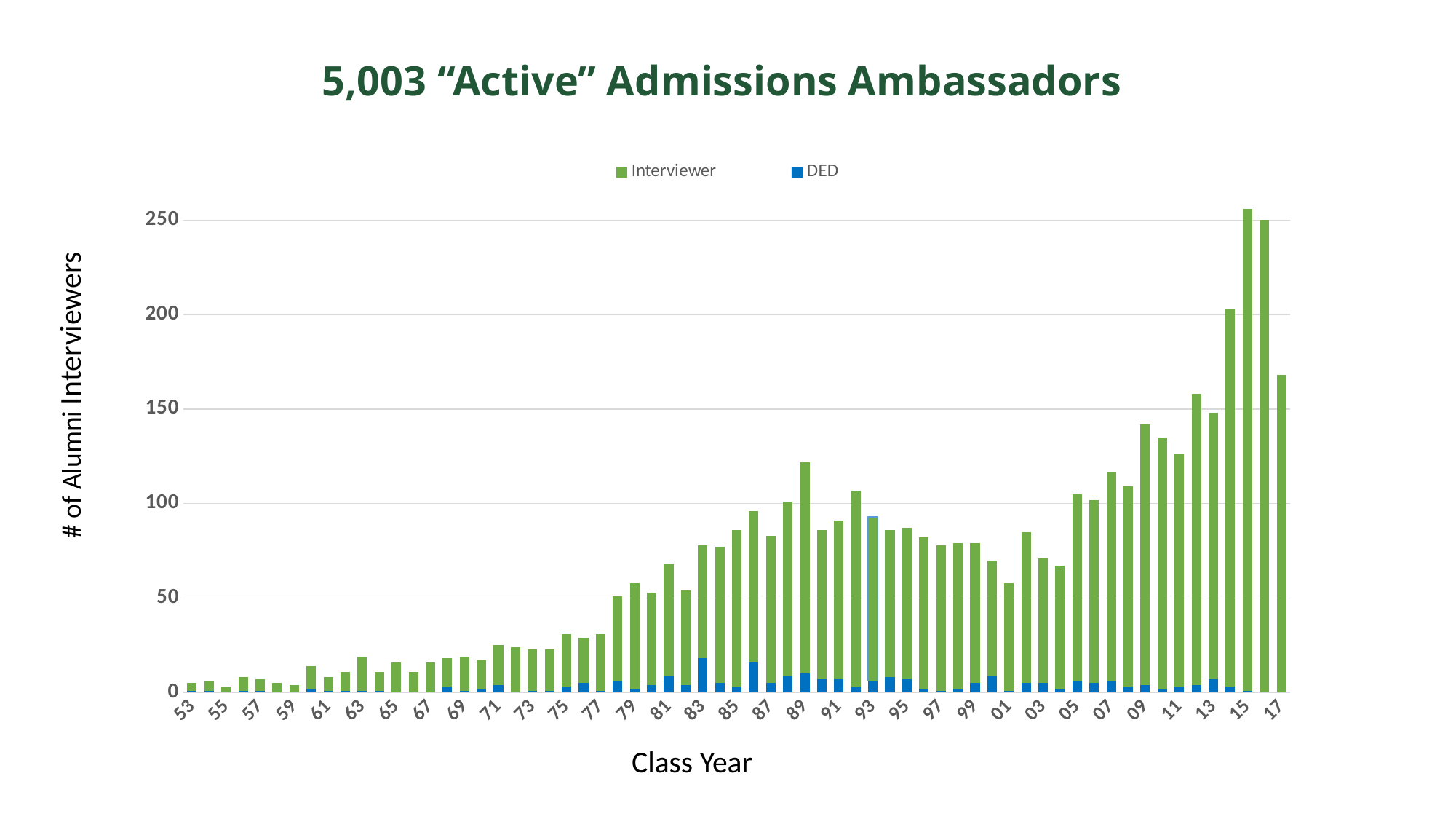
Which class year has the taller bar, 15 or 17? 15 What is the title of the chart? 5,003 "Active" Admissions Ambassadors Is the total bar for class year 17 greater or less than 150? greater What kind of chart is shown on the slide? Stacked bar chart Is the total bar for class year 15 greater or less than 250? greater Is the total bar for class year 01 greater or less than 50? greater How many series does the legend list? 2 Which class year has the taller bar, 89 or 91? 89 Which class year has the tallest bar? 15 What are the two series named in the legend? Interviewer and DED